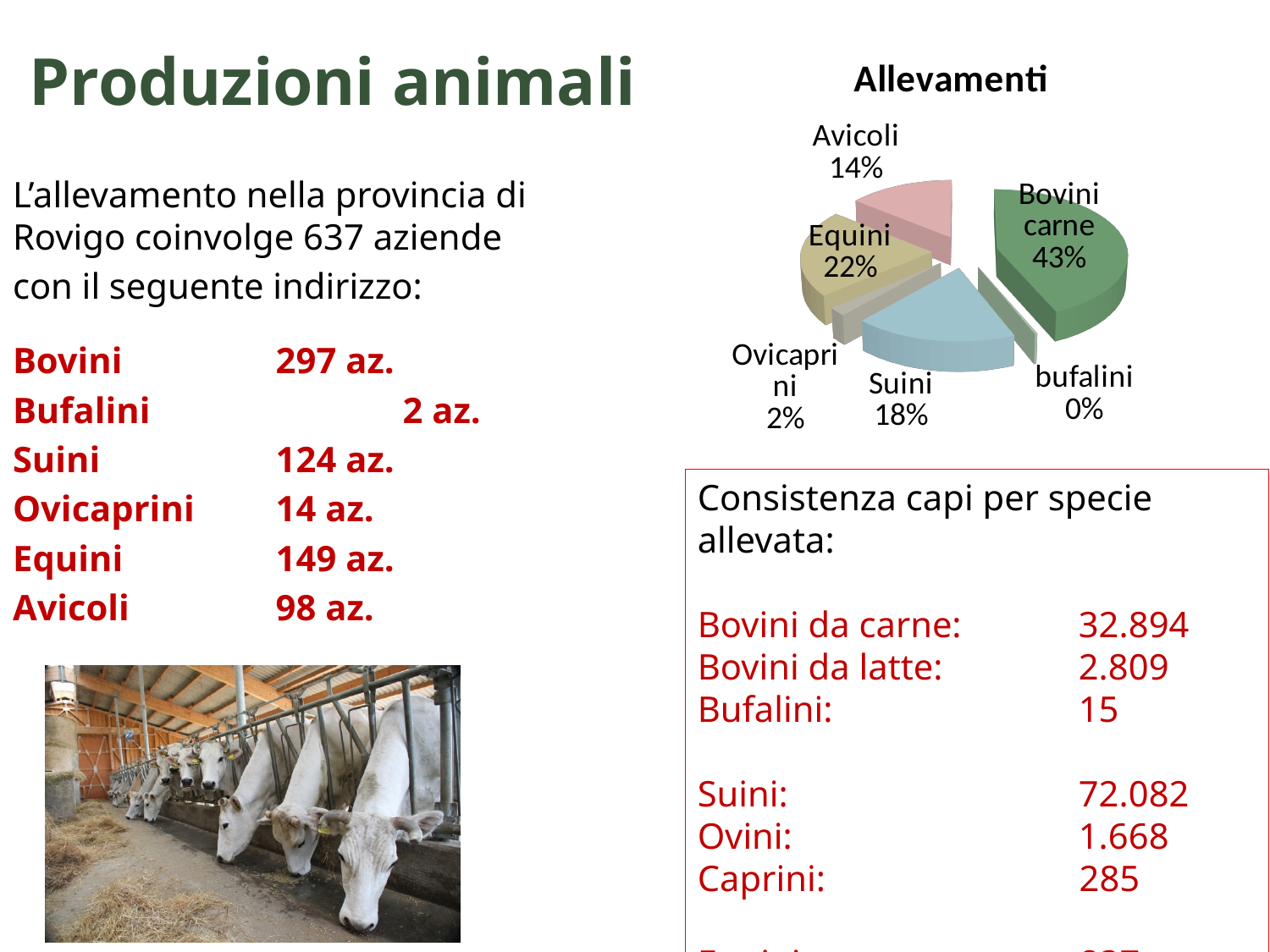
What type of chart is shown on the slide? pie chart In the Allevamenti pie chart, what is the difference in percentage points between Bovini carne and Avicoli? 29 What percentage of the Allevamenti pie chart is Suini? 18% Which category has the largest share in the Allevamenti pie chart? Bovini carne In the Allevamenti pie chart, which has a larger share, Equini or Suini? Equini What percentage of the Allevamenti pie chart is Equini? 22% Which category has the smallest share in the Allevamenti pie chart? bufalini What percentage of the Allevamenti pie chart is Avicoli? 14% How many slices does the Allevamenti pie chart have? 6 What is the title of the pie chart? Allevamenti